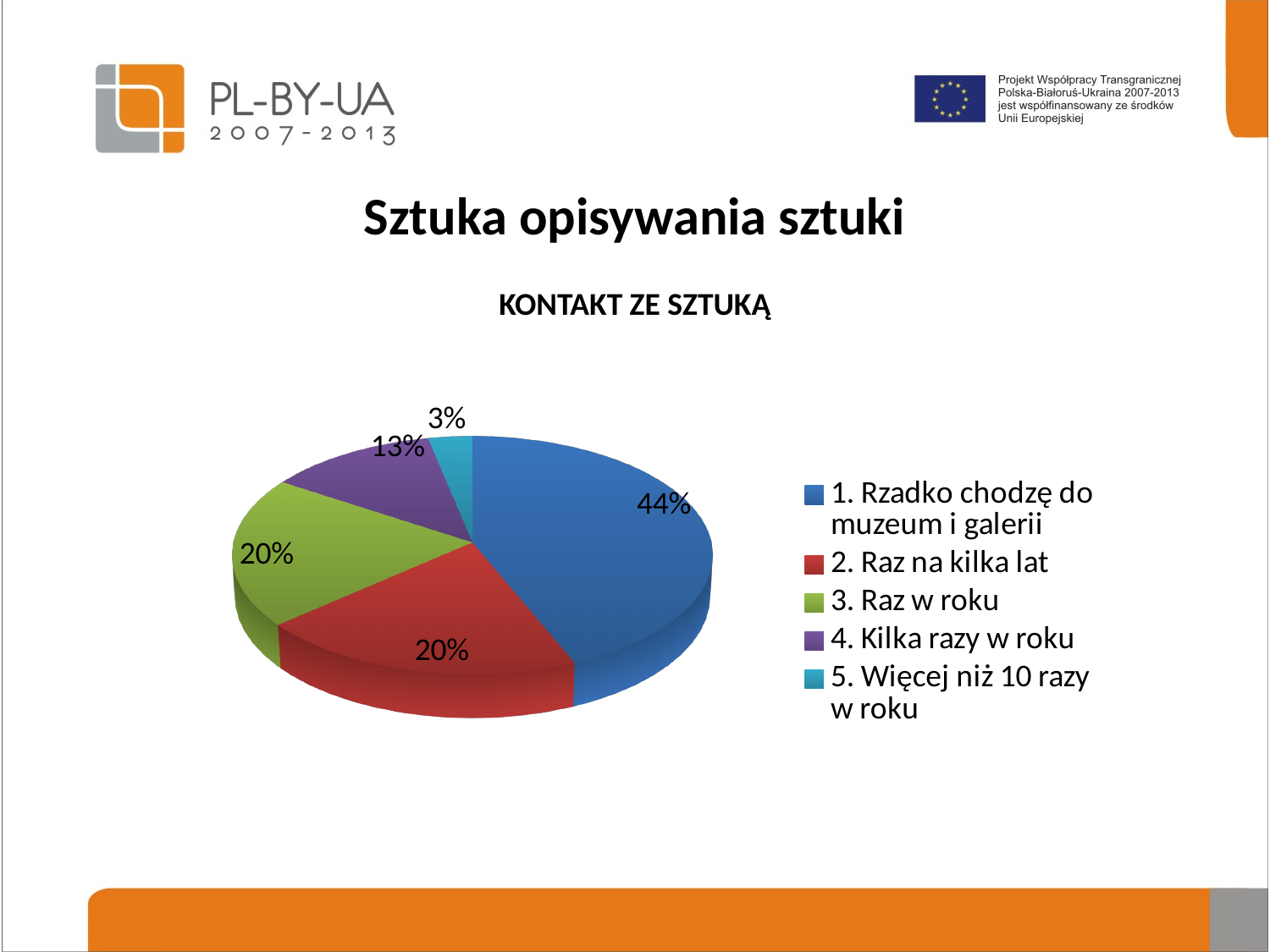
Which category has the smallest share of the pie? 5. Więcej niż 10 razy w roku What share of the pie is '3. Raz w roku'? 20% What colour is the slice for '2. Raz na kilka lat'? red What is the difference between the shares of '1. Rzadko chodzę do muzeum i galerii' and '2. Raz na kilka lat'? 24% What kind of chart is shown on the slide? pie chart What is the chart's title? KONTAKT ZE SZTUKĄ What share of the pie is '5. Więcej niż 10 razy w roku'? 3% Which category has the largest share of the pie? 1. Rzadko chodzę do muzeum i galerii How many categories does the pie chart have? 5 What share of the pie is '4. Kilka razy w roku'? 13% Which is larger, the share for '4. Kilka razy w roku' or the share for '5. Więcej niż 10 razy w roku'? 4. Kilka razy w roku